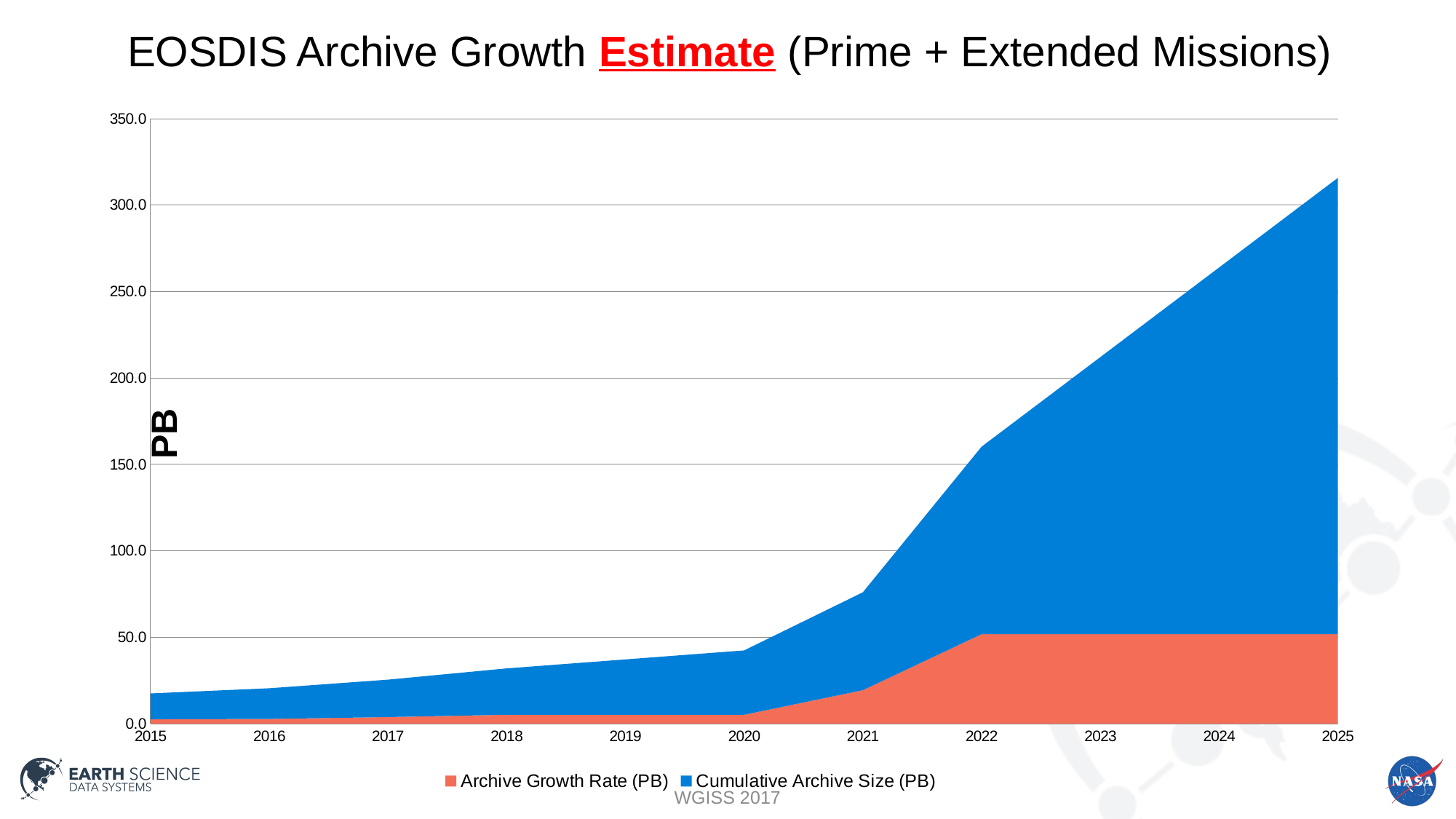
Is the Archive Growth Rate (PB) value for 2021 greater or less than 50? less Is the total stacked value for 2025 greater or less than 300? greater Do the stacked values rise or fall from 2015 to 2025? Rise How many years are shown along the x axis? 11 Which series is shown in blue? Cumulative Archive Size (PB) How many series does the legend list? 2 What is the label on the y axis? PB Which year has the lowest total stacked value? 2015 Which year has the highest total stacked value? 2025 What kind of chart is shown on the slide? Stacked area chart Is the total stacked value for 2020 greater or less than 50? less